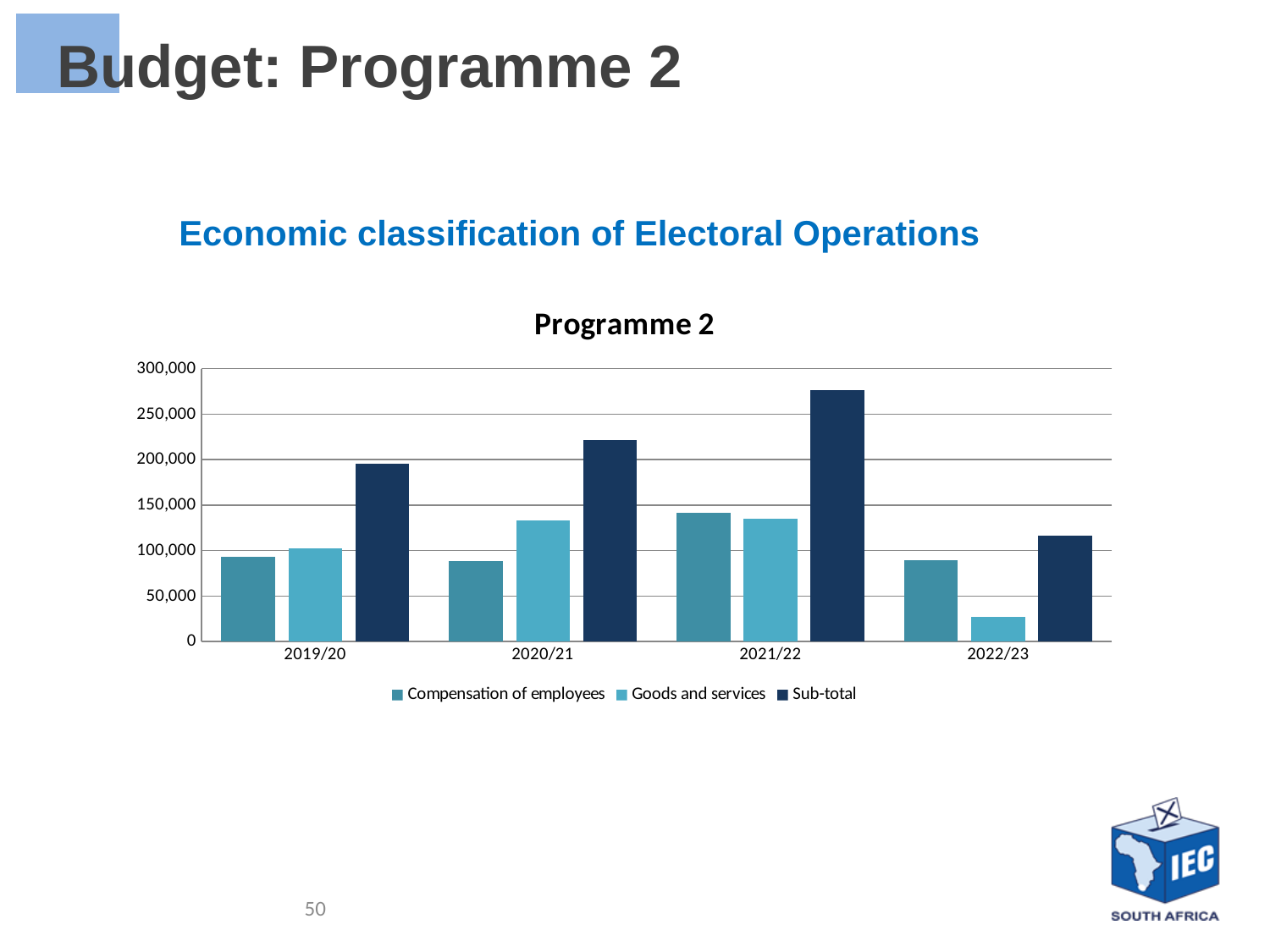
What kind of chart is shown on the slide? bar chart In 2020/21, which is larger: Compensation of employees or Goods and services? Goods and services In which year is the Sub-total highest? 2021/22 Is the value for Goods and services in 2022/23 greater or less than 50,000? less How many financial years are shown on the x axis? 4 What is the title of the chart? Programme 2 How many series does the legend list? 3 In which year is the Sub-total lowest? 2022/23 In which year is Compensation of employees highest? 2021/22 Does the Sub-total rise or fall from 2019/20 to 2021/22? rise In which year is Goods and services lowest? 2022/23 Is the Sub-total for 2021/22 greater or less than 250,000? greater